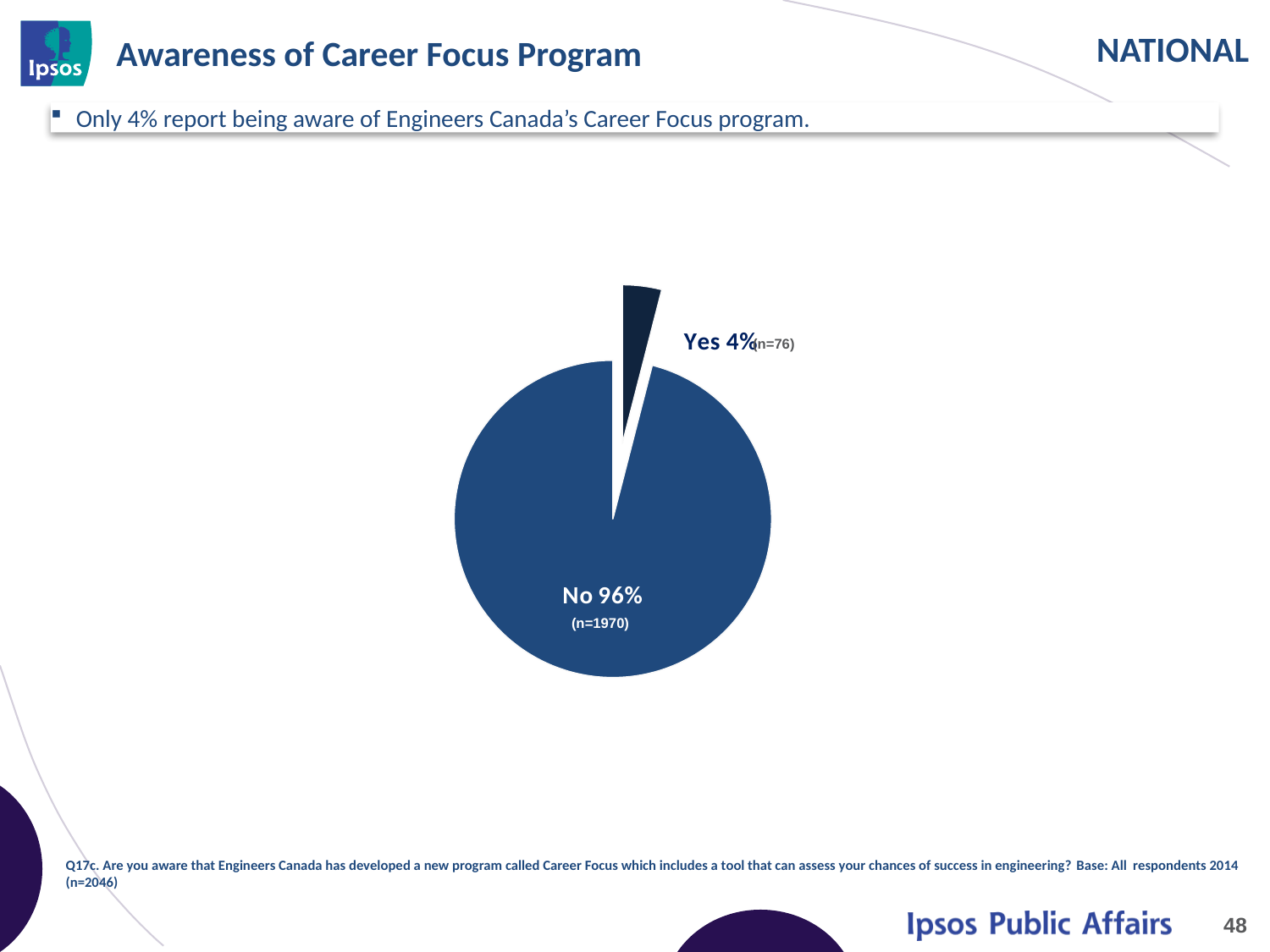
What is the difference in percentage points between the "No" and "Yes" slices? 92 What kind of chart is shown on the slide? Pie chart What percentage of respondents answered "No"? 96% How many slices does the pie chart have? 2 What is the sample size (n) shown for the "No" slice? n=1970 Which is larger, the "Yes" slice or the "No" slice? No Which slice of the pie is the largest? No Which slice of the pie is the smallest? Yes Is the "Yes" slice greater or less than 10% of the pie? less What is the title of the slide containing the pie chart? Awareness of Career Focus Program What is the sample size (n) shown for the "Yes" slice? n=76 What percentage of respondents answered "Yes" to being aware of the Career Focus program? 4%